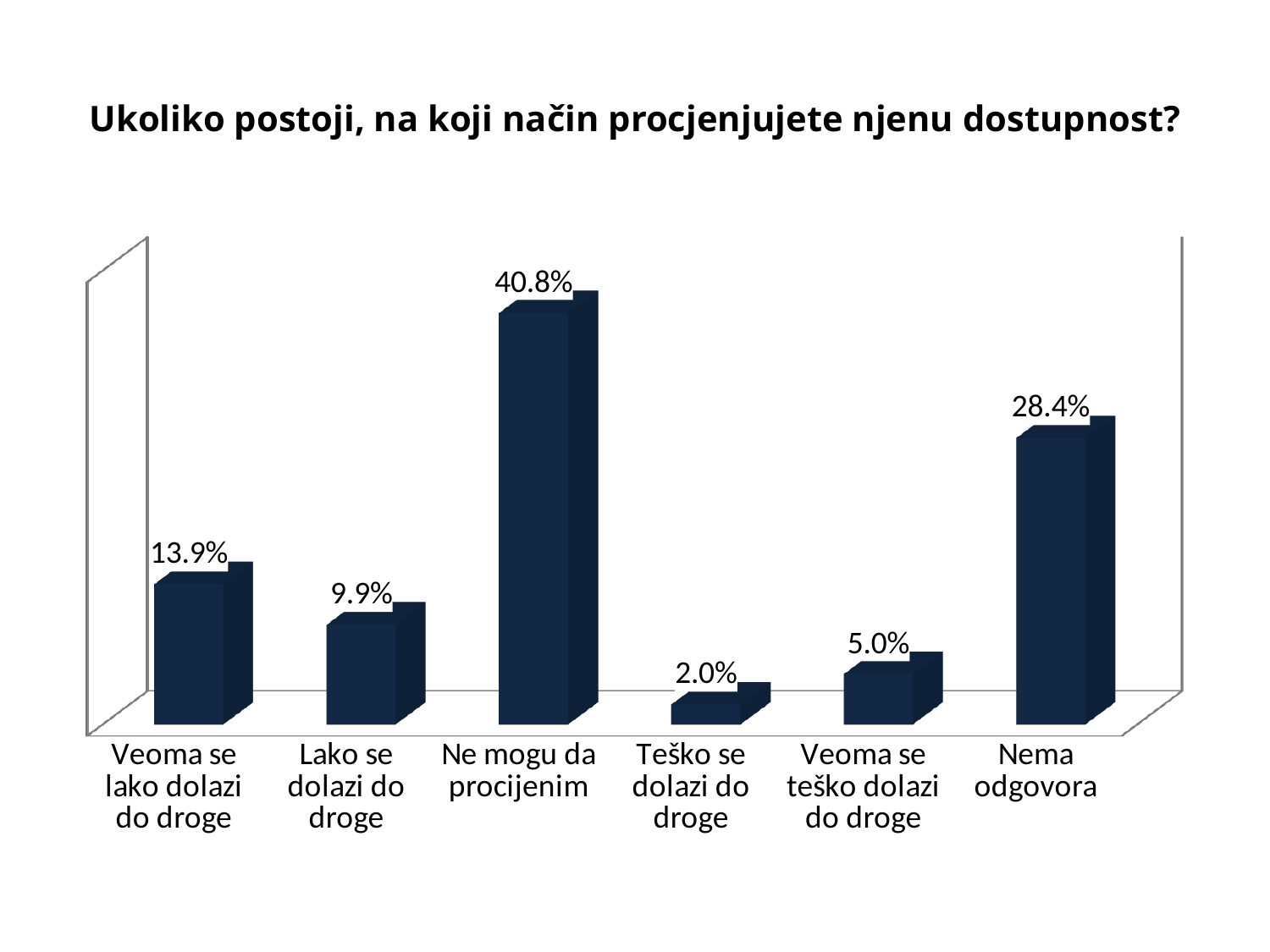
Which category has the highest value? Ne mogu da procijenim How many categories are shown on the chart? 6 What is the value for "Nema odgovora"? 28.4% What is the title of the chart? Ukoliko postoji, na koji način procjenjujete njenu dostupnost? What kind of chart is shown on the slide? Bar chart What is the difference between "Ne mogu da procijenim" and "Nema odgovora"? 12.4% What is the value for "Teško se dolazi do droge"? 2.0% Which category has the lowest value? Teško se dolazi do droge What is the difference between "Veoma se lako dolazi do droge" and "Lako se dolazi do droge"? 4.0% Which is larger, "Veoma se teško dolazi do droge" or "Lako se dolazi do droge"? Lako se dolazi do droge What is the value for "Ne mogu da procijenim"? 40.8% What is the value for "Veoma se lako dolazi do droge"? 13.9%